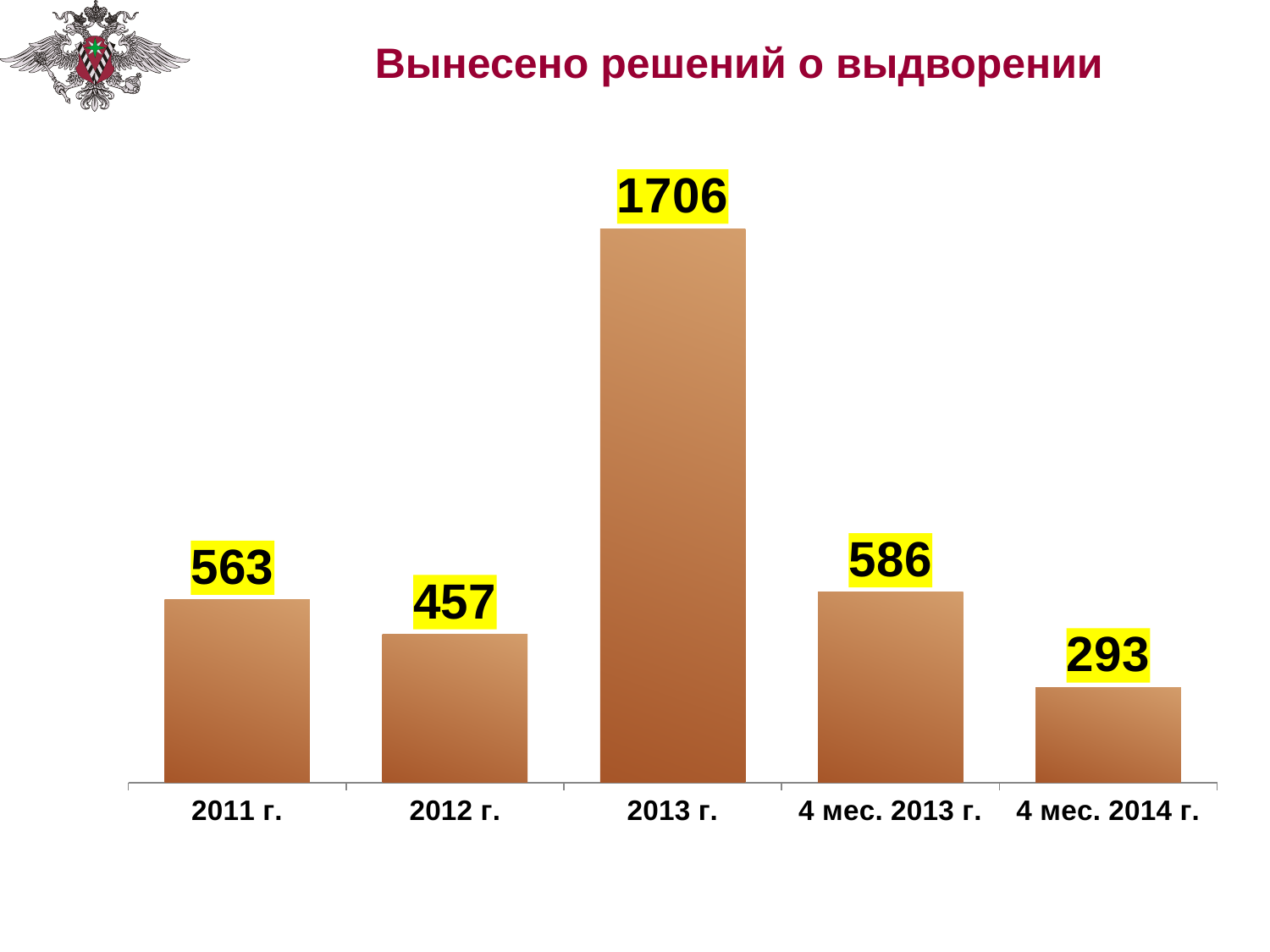
What is the value for 2011 г.? 563 Which category has the highest value? 2013 г. What is the value for 4 мес. 2014 г.? 293 What kind of chart is shown on the slide? Bar chart What is the value for 2013 г.? 1706 Which category has the lowest value? 4 мес. 2014 г. Which is larger, the value for 2011 г. or the value for 4 мес. 2013 г.? 4 мес. 2013 г. How many categories are shown on the chart? 5 What is the value for 2012 г.? 457 What is the difference between the values for 2011 г. and 2012 г.? 106 What is the difference between the values for 4 мес. 2013 г. and 4 мес. 2014 г.? 293 What is the value for 4 мес. 2013 г.? 586